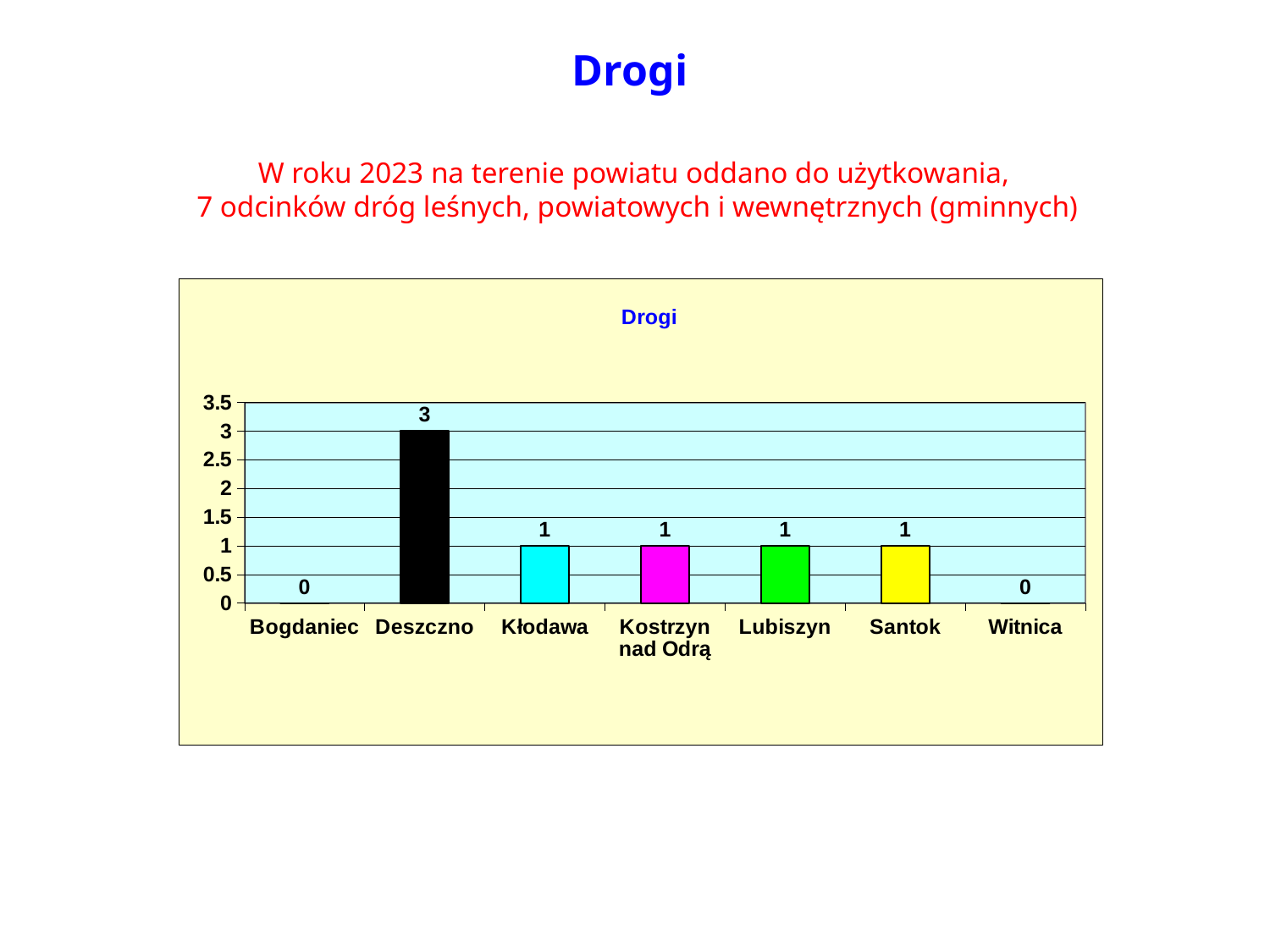
What kind of chart is shown? bar chart What colour is the bar for Deszczno? black Which is larger, the value for Deszczno or the value for Lubiszyn? Deszczno Which category has the highest value? Deszczno What is the value for Deszczno? 3 Is the value for Deszczno greater or less than 2? greater What is the value for Witnica? 0 What is the value for Bogdaniec? 0 What is the value for Kłodawa? 1 How many categories are shown on the x axis? 7 What is the title of the chart? Drogi What is the difference between the values for Deszczno and Santok? 2